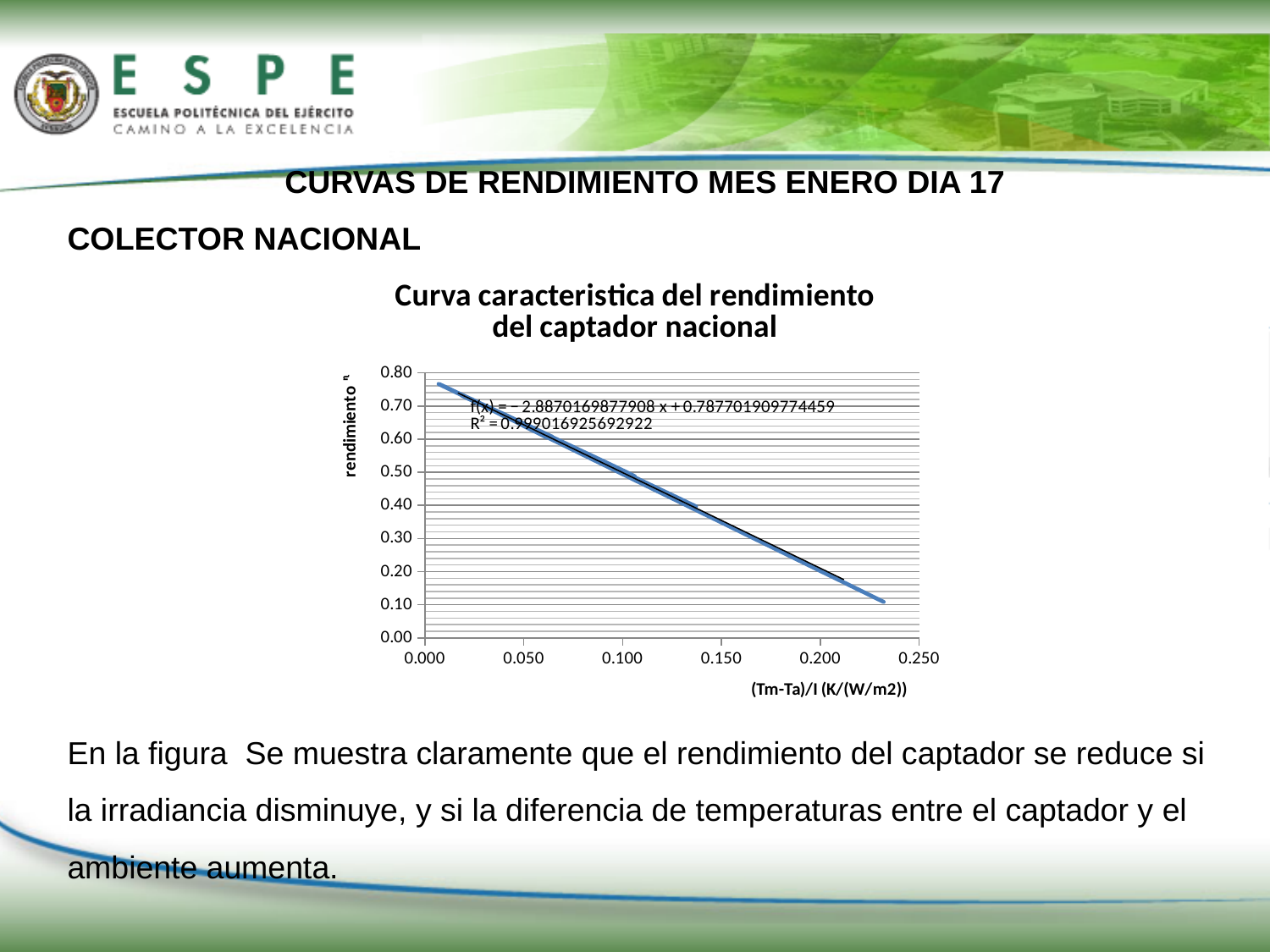
Is the rendimiento value at (Tm-Ta)/I = 0.050 greater or less than 0.50? greater What kind of chart is shown on the slide? line chart What is the R² value printed on the chart? 0.999016925692922 What is the title of the chart? Curva caracteristica del rendimiento del captador nacional What is the label of the x axis of the chart? (Tm-Ta)/I (K/(W/m2)) Is the rendimiento value at (Tm-Ta)/I = 0.150 greater or less than 0.40? less What is the intercept of the trendline equation printed on the chart? 0.787701909774459 What is the highest tick value shown on the x axis of the chart? 0.250 What is the highest tick value shown on the y axis of the chart? 0.80 What is the slope of the trendline equation printed on the chart? −2.8870169877908 Does the rendimiento rise or fall as (Tm-Ta)/I increases along the x axis? fall